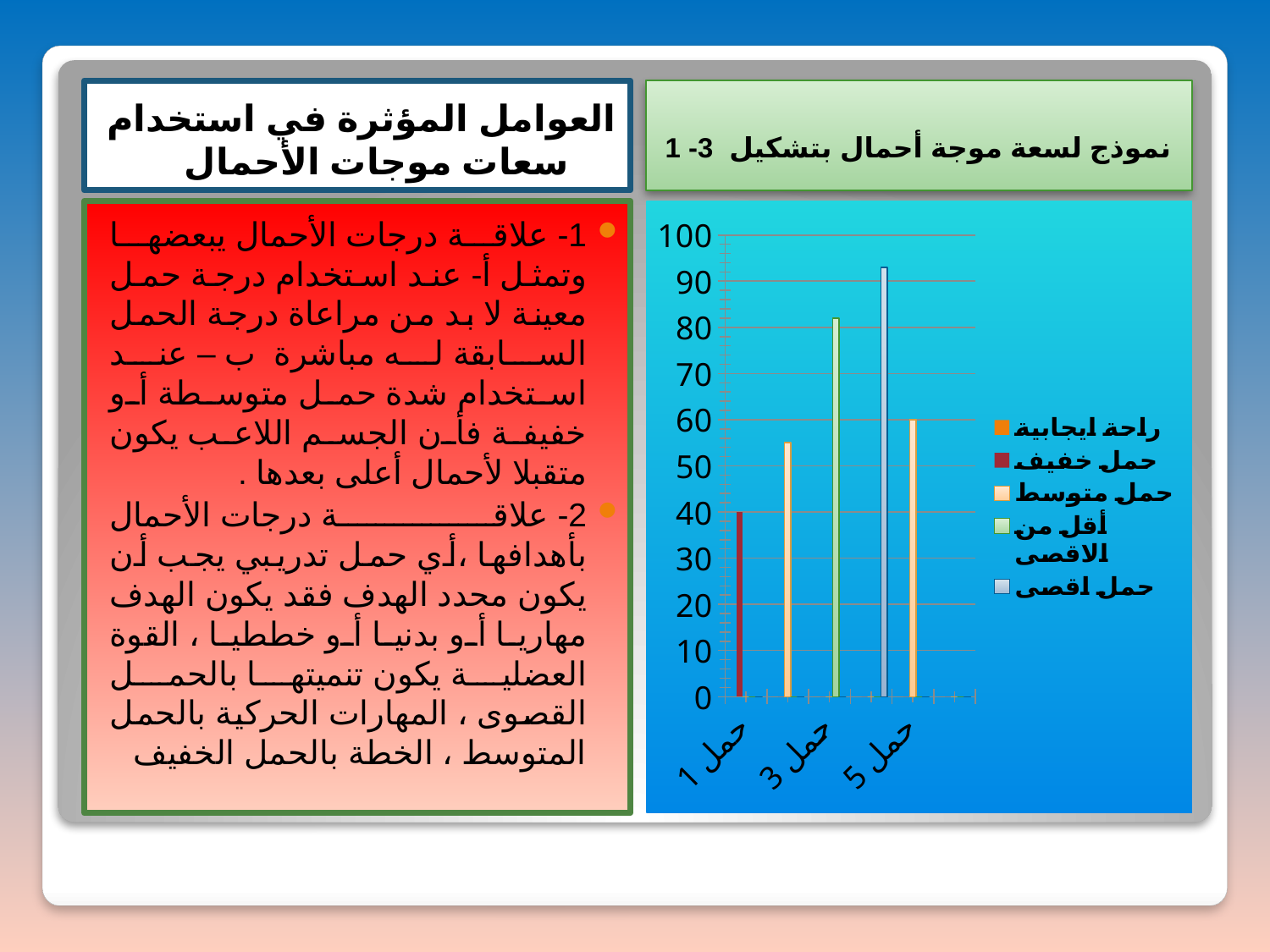
Is the value of the حمل اقصى bar greater or less than 80? greater Which is larger, the bar for حمل 1 or the bar for حمل 3? حمل 3 Is the value for حمل 5 greater or less than 50? greater Which legend series has the tallest bar in the chart? حمل اقصى How many bars are plotted in the chart? 5 Is the value for حمل 1 greater or less than 50? less What is the title of the chart? نموذج لسعة موجة أحمال بتشكيل 3-1 How many series does the chart legend list? 5 What kind of chart is shown on the slide? bar chart Which legend entry is shown in dark red? حمل خفيف Which legend series has the shortest bar in the chart? حمل خفيف